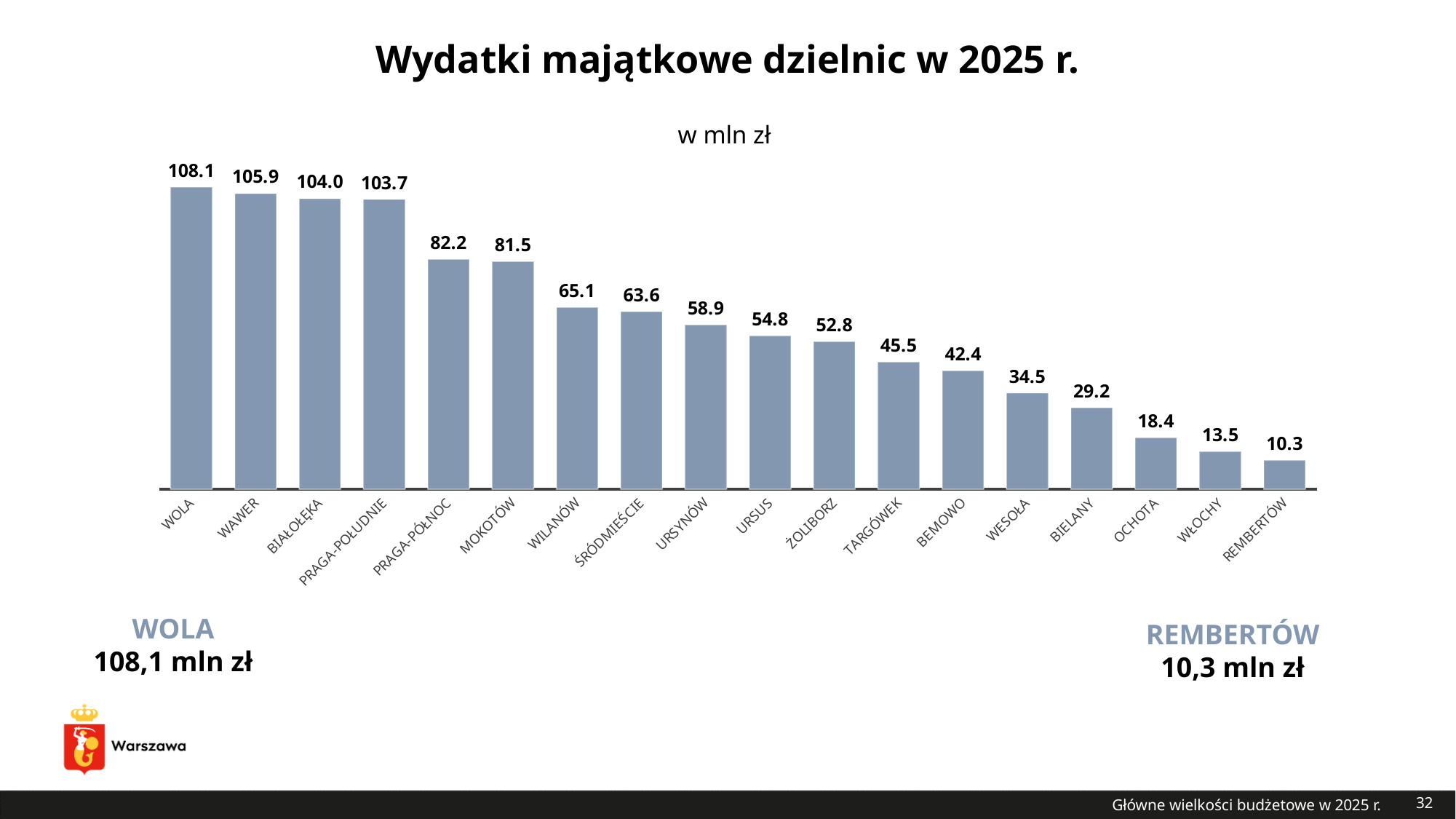
Which is larger, the value for Ursynów or the value for Bemowo? Ursynów How many districts are shown in the chart? 18 Which district has the highest value? Wola What is the value for Targówek? 45.5 Do the values rise or fall from left to right along the x axis? Fall Which district has the lowest value? Rembertów What is the value for Mokotów? 81.5 What kind of chart is shown on the slide? Bar chart What is the difference between the values for Praga-Północ and Mokotów? 0.7 What is the title of the chart? Wydatki majątkowe dzielnic w 2025 r. What is the value for Bielany? 29.2 What is the difference between the values for Wola and Rembertów? 97.8